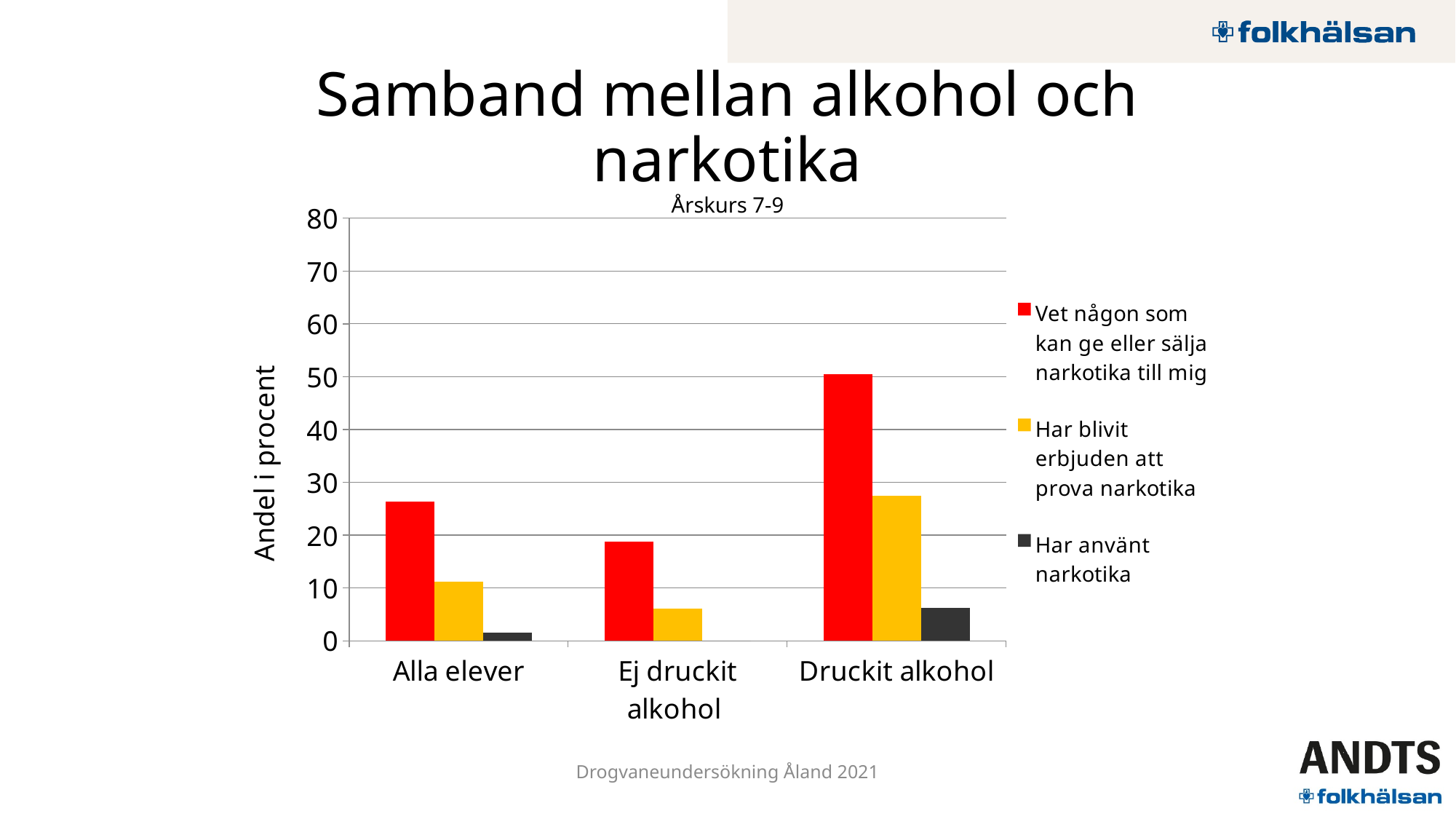
Which category has the highest value for 'Vet någon som kan ge eller sälja narkotika till mig'? Druckit alkohol What kind of chart is shown on the slide? bar chart What is the label on the vertical axis? Andel i procent Which category has the lowest value for 'Vet någon som kan ge eller sälja narkotika till mig'? Ej druckit alkohol Is the value for 'Har blivit erbjuden att prova narkotika' in the 'Alla elever' category greater or less than 20? less Which is larger for 'Har blivit erbjuden att prova narkotika': 'Alla elever' or 'Ej druckit alkohol'? Alla elever Is the value for 'Har blivit erbjuden att prova narkotika' in the 'Druckit alkohol' category greater or less than 20? greater What is the title shown above the chart? Årskurs 7-9 How many categories are shown on the x axis? 3 How many series does the legend list? 3 Is the value for 'Vet någon som kan ge eller sälja narkotika till mig' in the 'Alla elever' category greater or less than 30? less